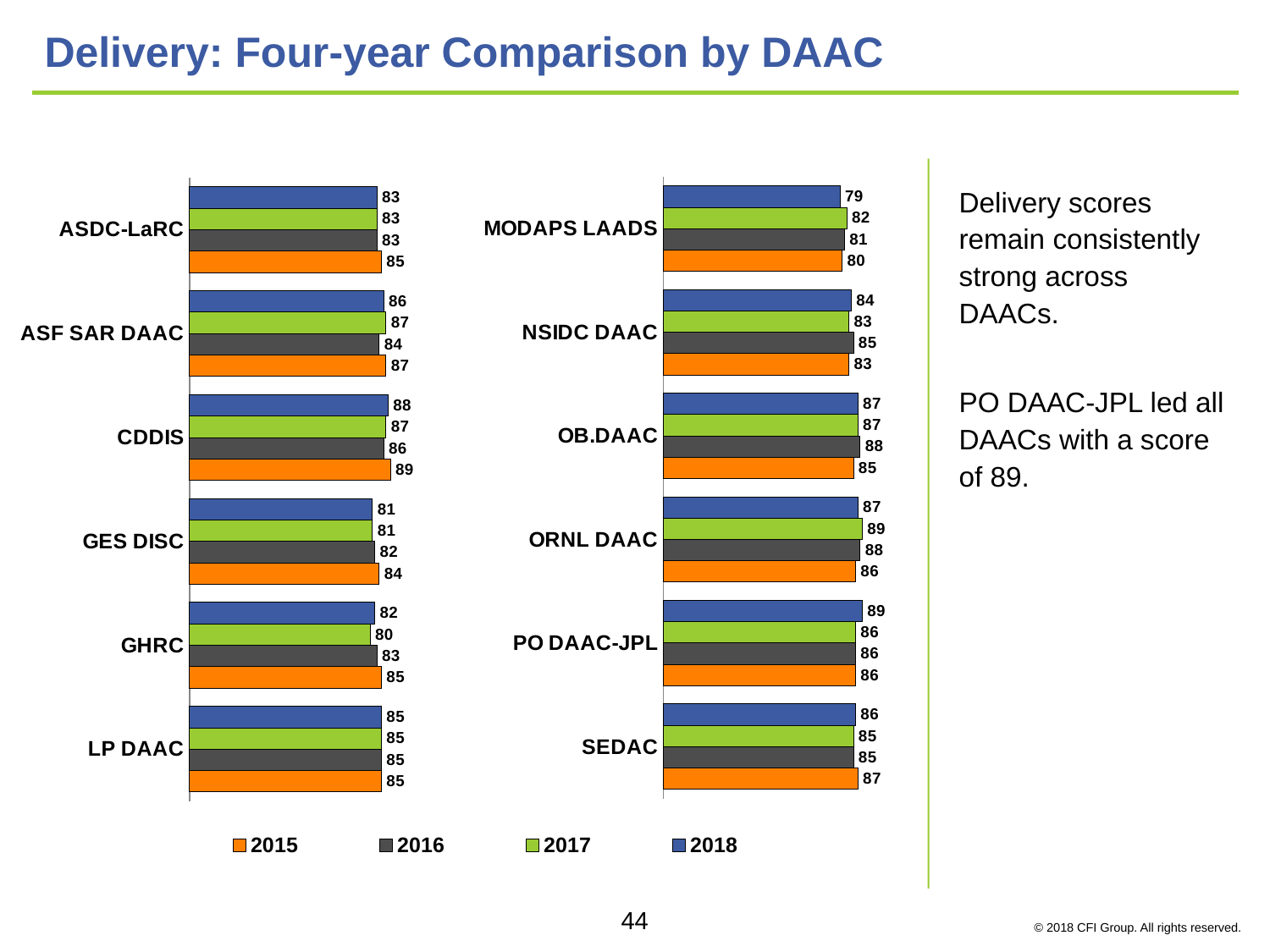
On the left chart, what is the difference between the 2015 and 2018 values for GES DISC? 3 What type of chart is used on this slide? Bar chart On the right chart, what is the 2017 value for MODAPS LAADS? 82 On the left chart, what is the 2018 value for CDDIS? 88 How many series does the legend list? 4 On the left chart, which DAAC has the lowest 2017 value? GHRC On the left chart, what is the 2016 value for GHRC? 83 On the right chart, which DAAC has the highest 2018 value? PO DAAC-JPL How many DAACs are shown on the left chart? 6 On the right chart, which DAAC has the lowest 2018 value? MODAPS LAADS On the right chart, what is the 2015 value for SEDAC? 87 On the right chart, which is larger for ORNL DAAC: the 2017 value or the 2015 value? 2017